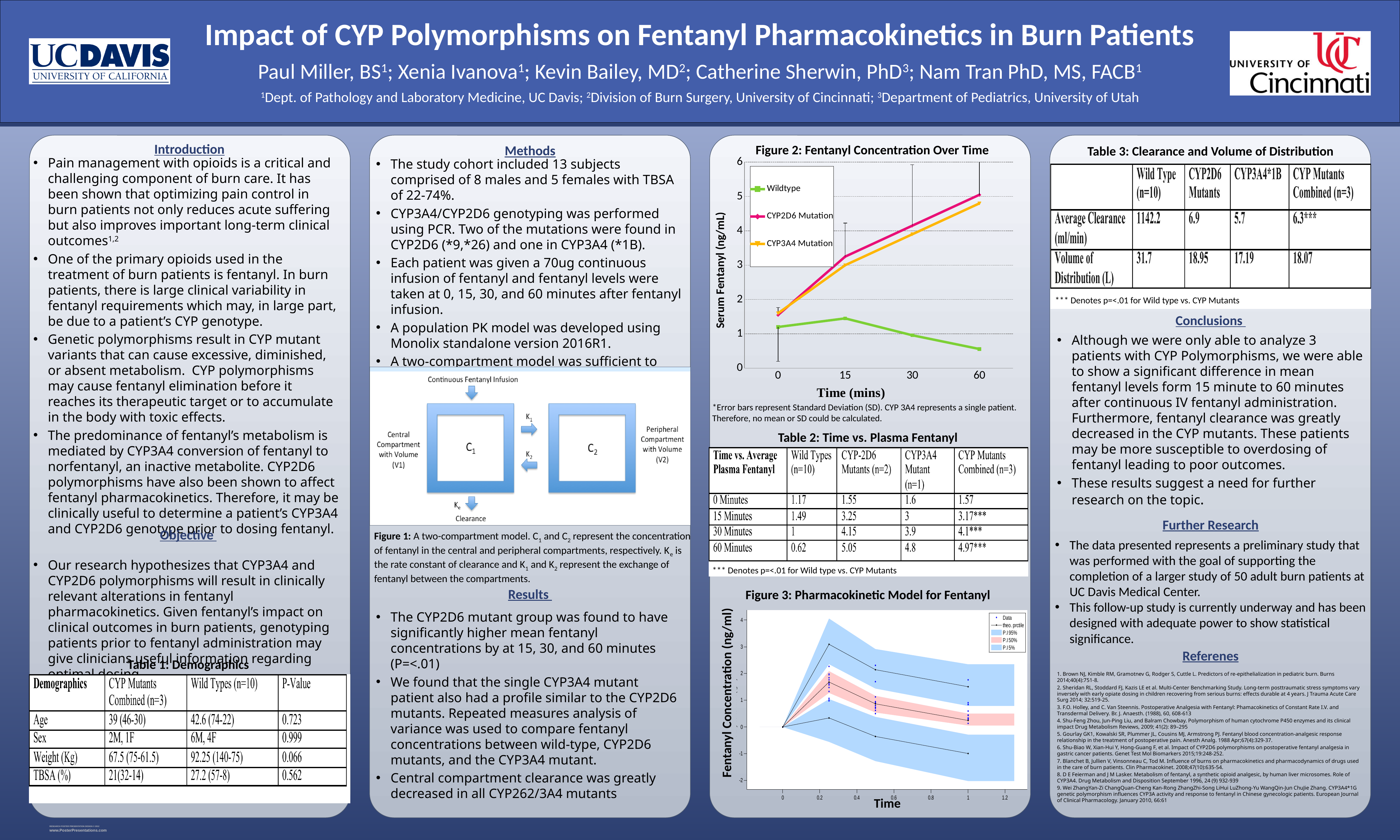
In Figure 2: Fentanyl Concentration Over Time, at 30 minutes, which is larger: the CYP2D6 Mutation value or the Wildtype value? CYP2D6 Mutation In Figure 3: Pharmacokinetic Model for Fentanyl, what is the label of the y axis? Fentanyl Concentration (ng/ml) In Figure 2: Fentanyl Concentration Over Time, how many series does the legend list? 3 In Figure 2: Fentanyl Concentration Over Time, does the CYP3A4 Mutation series rise or fall from 0 to 60 minutes? rise In Figure 2: Fentanyl Concentration Over Time, what kind of chart is shown? line chart In Figure 2: Fentanyl Concentration Over Time, what is the label of the y axis? Serum Fentanyl (ng/mL) In Figure 2: Fentanyl Concentration Over Time, which series has the highest value at 60 minutes? CYP2D6 Mutation In Figure 2: Fentanyl Concentration Over Time, is the Wildtype value at 60 minutes greater or less than 1? less In Figure 2: Fentanyl Concentration Over Time, does the Wildtype series rise or fall from 15 minutes to 60 minutes? fall In Figure 2: Fentanyl Concentration Over Time, how many time points are plotted along the x axis? 4 In Figure 2: Fentanyl Concentration Over Time, which series has the lowest value at 60 minutes? Wildtype In Figure 2: Fentanyl Concentration Over Time, is the CYP2D6 Mutation value at 15 minutes greater or less than 2? greater